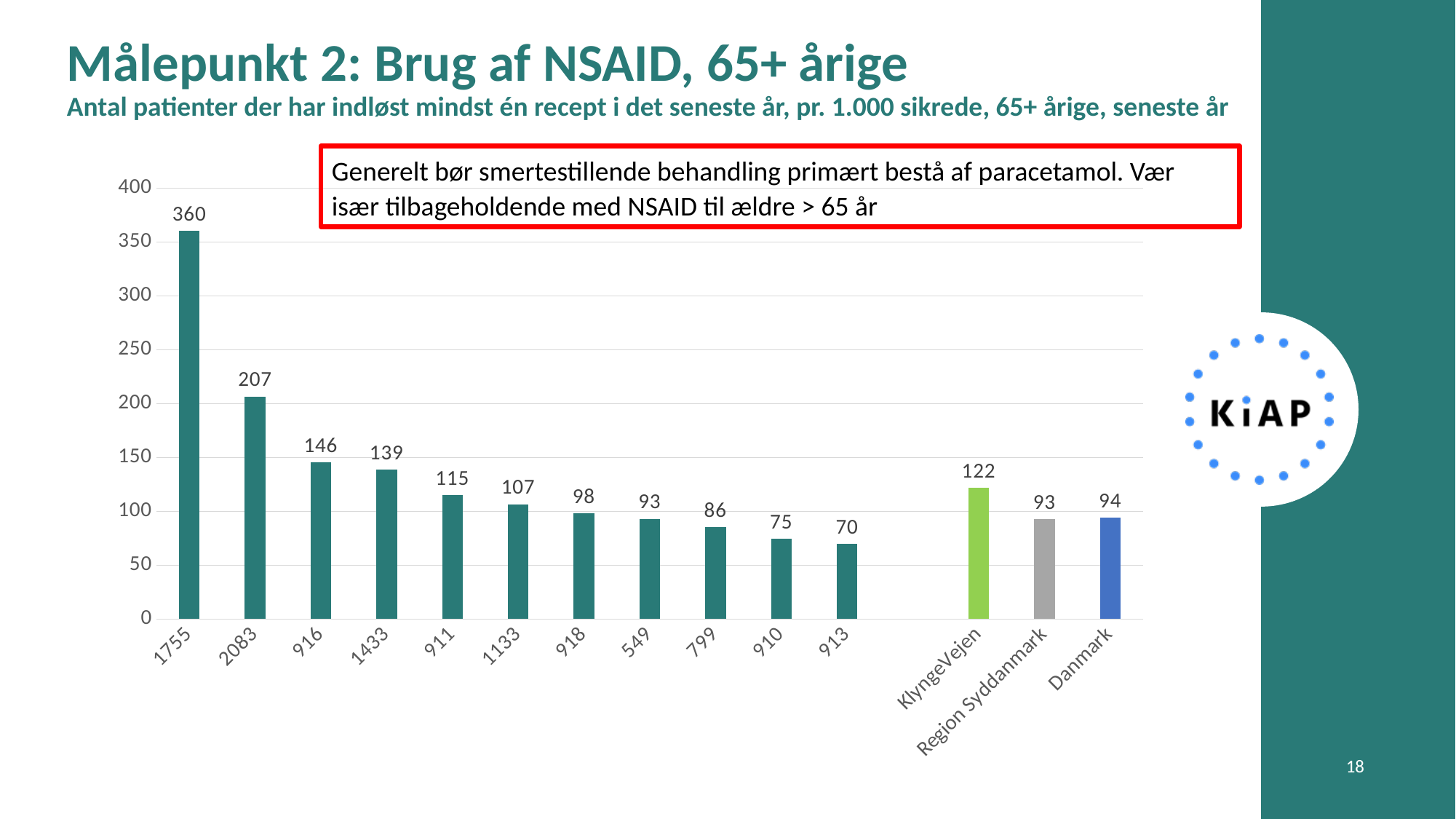
Which is larger, the value for 916 or the value for 1433? 916 How many bars are shown in the chart? 14 Which category has the lowest value? 913 What is the value for Region Syddanmark? 93 What is the value for category 1755? 360 What is the difference between the values for 1755 and 2083? 153 What is the value for KlyngeVejen? 122 What colour is the bar for KlyngeVejen? Green What is the value for Danmark? 94 What is the difference between the values for KlyngeVejen and Danmark? 28 Which category has the highest value? 1755 What kind of chart is shown on the slide? Bar chart